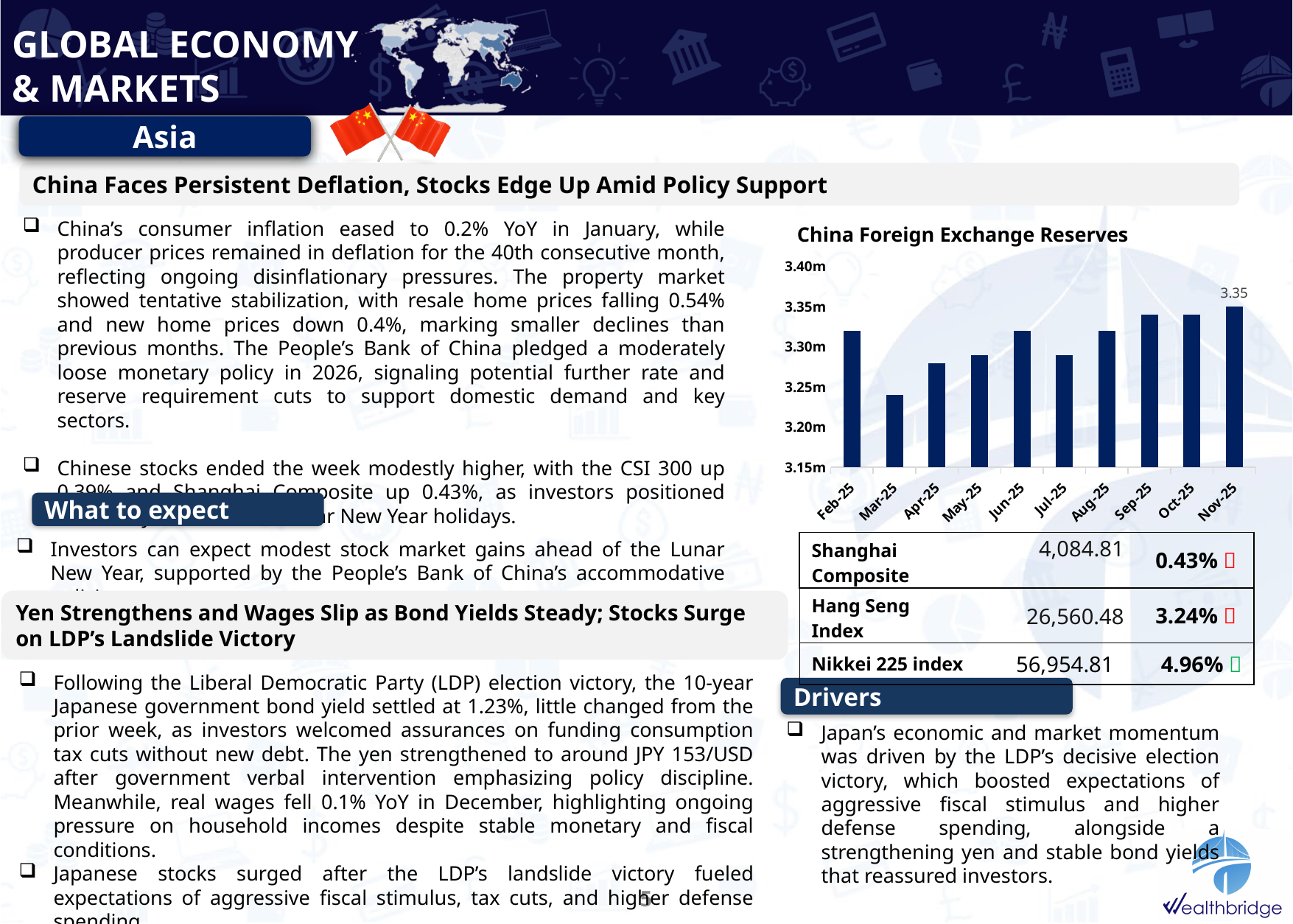
In the China Foreign Exchange Reserves chart, which is larger, the value for Apr-25 or Jun-25? Jun-25 Is the value for Feb-25 in the China Foreign Exchange Reserves chart greater or less than 3.30m? greater Is the value for Mar-25 in the China Foreign Exchange Reserves chart greater or less than 3.30m? less Which month has the highest value in the China Foreign Exchange Reserves chart? Nov-25 Which month has the lowest value in the China Foreign Exchange Reserves chart? Mar-25 In the China Foreign Exchange Reserves chart, which is larger, the value for Feb-25 or Mar-25? Feb-25 What is the title of the chart on the slide? China Foreign Exchange Reserves How many months are plotted in the China Foreign Exchange Reserves chart? 10 In the China Foreign Exchange Reserves chart, do the values rise or fall from Jul-25 to Nov-25? rise Is the value for Apr-25 in the China Foreign Exchange Reserves chart greater or less than 3.30m? less What value is labelled for Nov-25 in the China Foreign Exchange Reserves chart? 3.35 What kind of chart is the China Foreign Exchange Reserves chart? bar chart